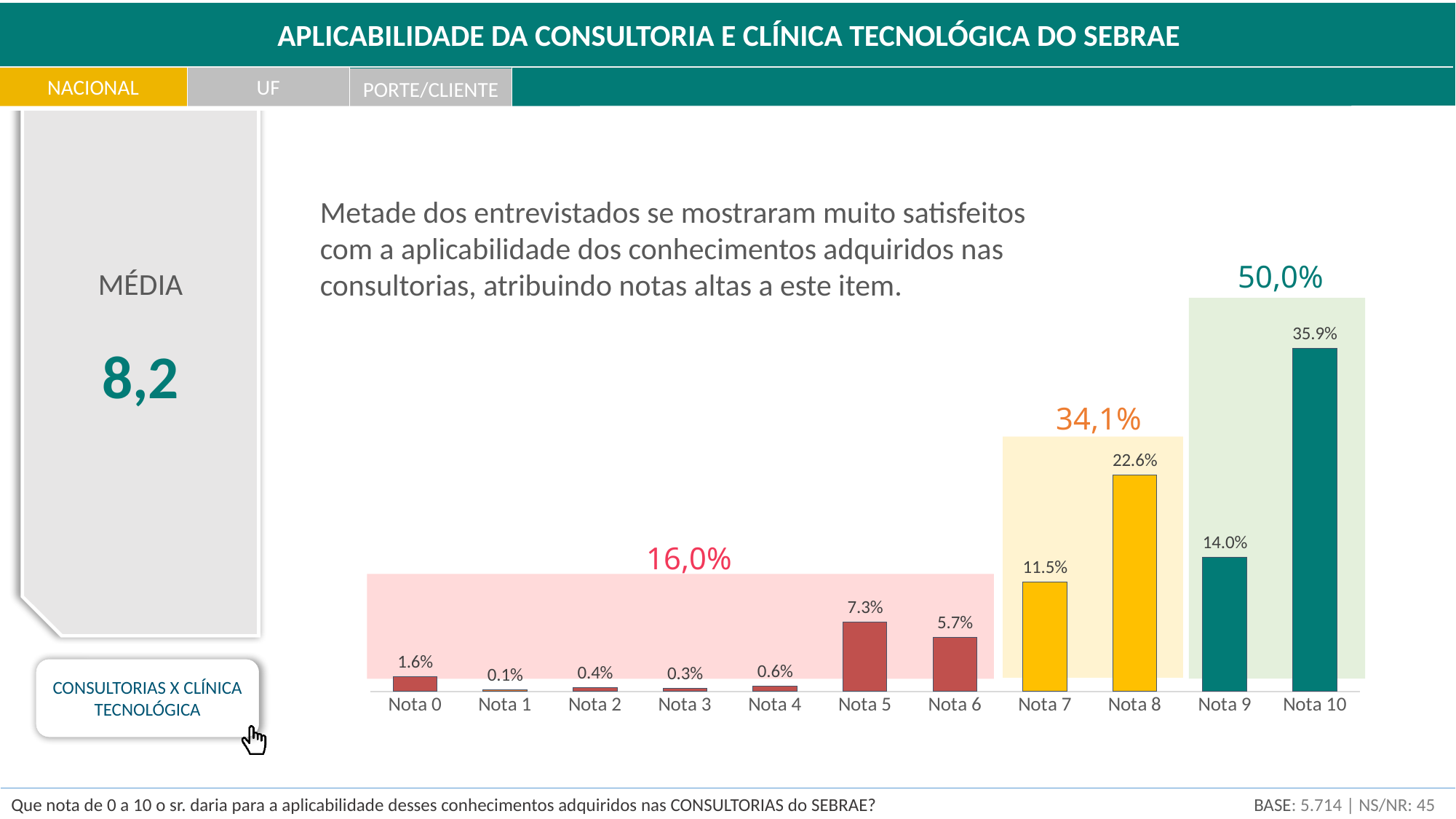
What is the value for Nota 10? 35.9% How many categories are shown on the x axis? 11 What is the difference between the values for Nota 9 and Nota 7? 2.5% Which is larger, the value for Nota 5 or the value for Nota 6? Nota 5 Which category has the lowest value? Nota 1 What percentage is shown above the pink shaded group covering Nota 0 to Nota 6? 16,0% What is the value for Nota 5? 7.3% What is the difference between the values for Nota 10 and Nota 8? 13.3% What percentage is shown above the green shaded group covering Nota 9 and Nota 10? 50,0% What is the value for Nota 8? 22.6% What kind of chart is shown on the slide? Bar chart Which category has the highest value? Nota 10